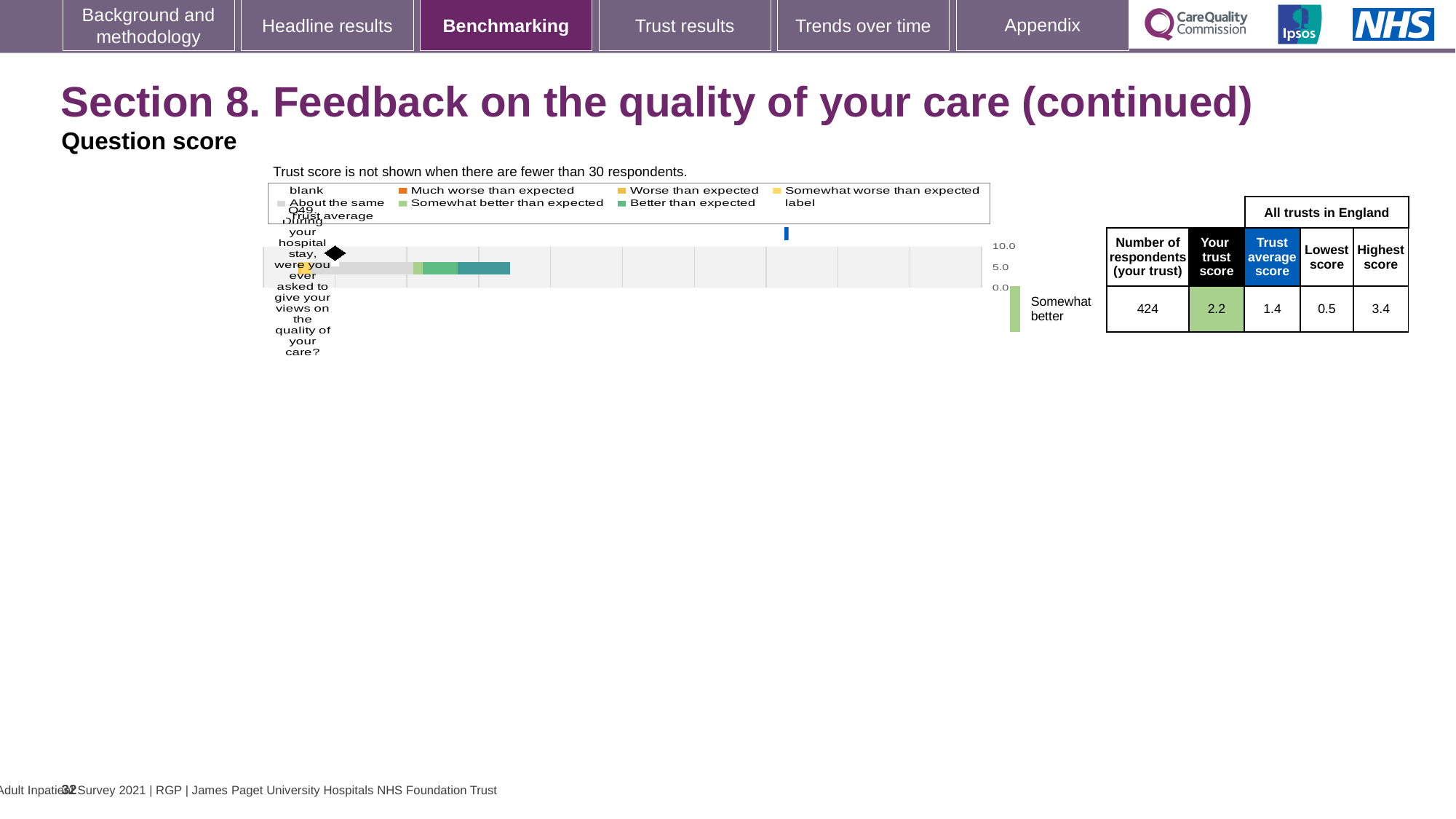
Which is larger for Q49: the trust score or the trust average score? Trust score According to the table beside the chart, what is the trust average score for Q49? 1.4 What benchmark category label is shown next to the chart for Q49? Somewhat better What is the difference between the trust score (2.2) and the trust average score (1.4) for Q49? 0.8 How many questions (categories) are plotted on the benchmarking chart? 1 What is the highest tick value shown on the chart's axis? 10.0 According to the table beside the chart, how many respondents answered Q49 for this trust? 424 What kind of chart is used to show the Q49 benchmarking result? Bar chart Is the trust score marker for Q49 on the chart greater or less than 5.0? less According to the table beside the chart, what is the highest score among all trusts in England for Q49? 3.4 Which question number is plotted on the benchmarking chart? Q49 According to the table beside the chart, what is the trust score for Q49? 2.2